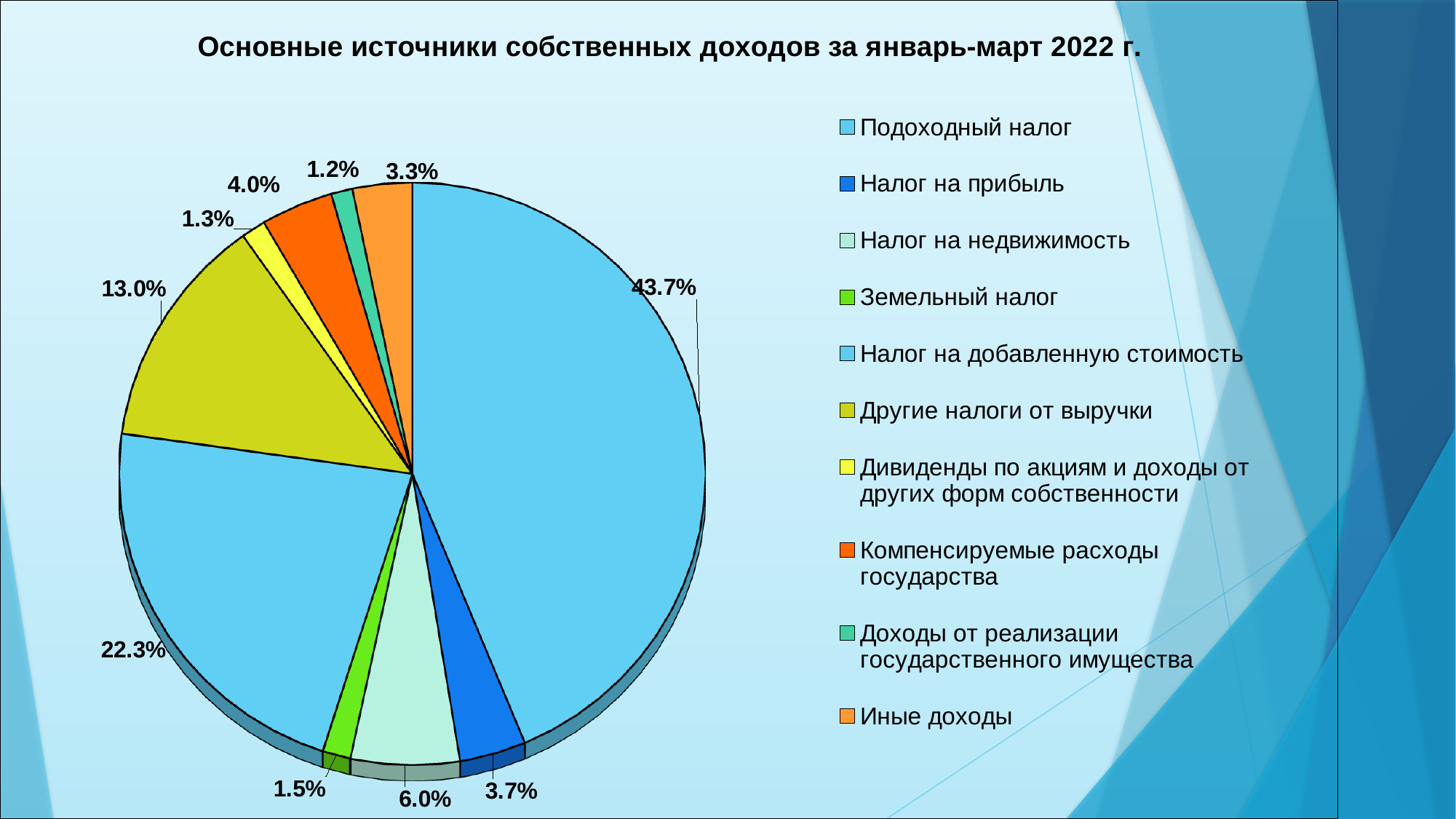
What kind of chart is shown on the slide? Pie chart What is the share of Подоходный налог in the pie chart? 43.7% What is the share of Иные доходы? 3.3% Which category has the smallest share of the pie? Доходы от реализации государственного имущества How many categories does the legend list? 10 Which category has the largest share of the pie? Подоходный налог What is the share of Налог на недвижимость? 6.0% Which is larger: the share of Налог на прибыль or the share of Компенсируемые расходы государства? Компенсируемые расходы государства What is the share of Другие налоги от выручки? 13.0% What is the difference between the shares of Подоходный налог and Налог на добавленную стоимость? 21.4% What is the share of Налог на добавленную стоимость? 22.3% What is the title of the chart? Основные источники собственных доходов за январь-март 2022 г.